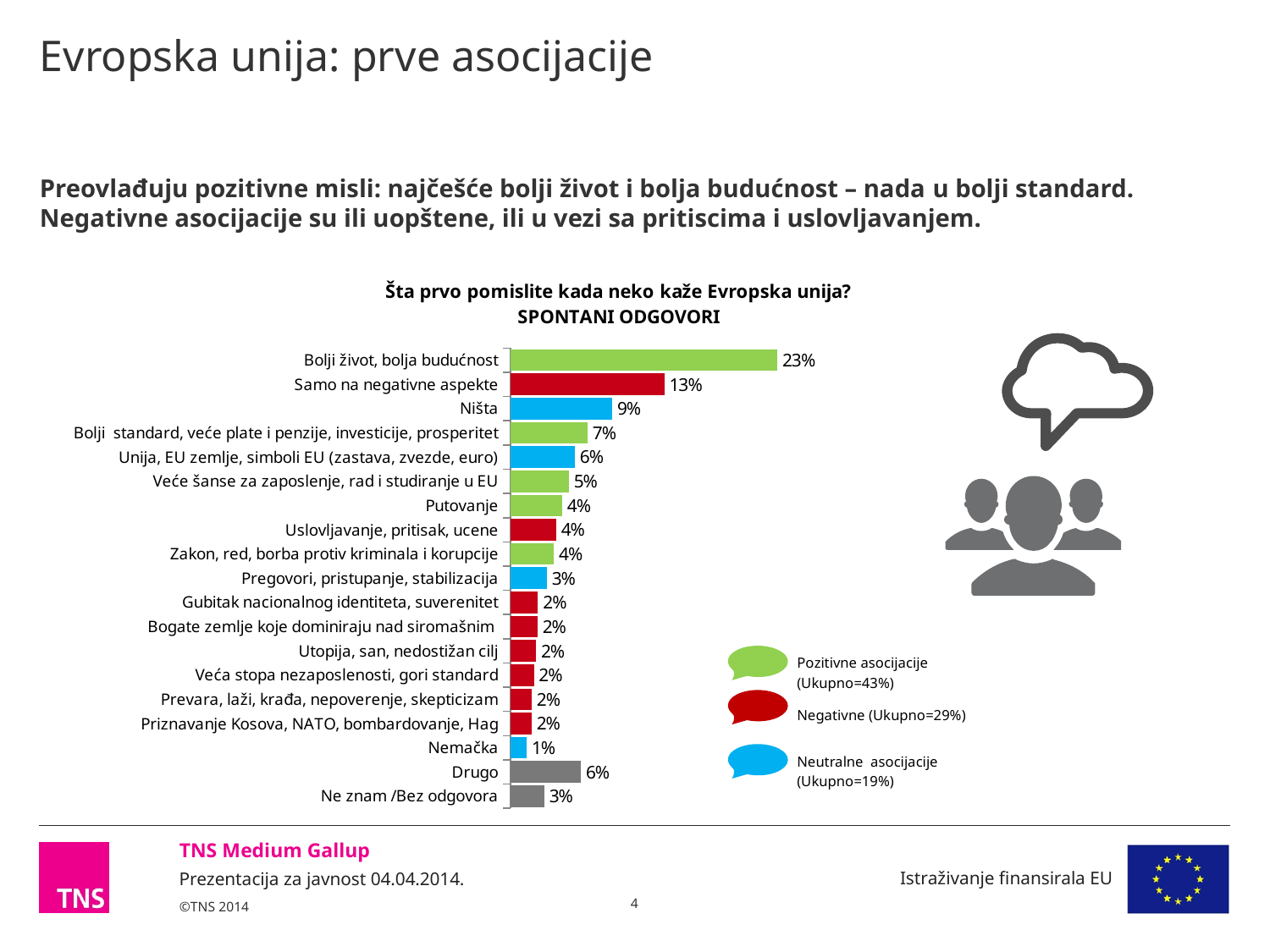
What type of chart is shown on the slide? Bar chart Which category has the highest value in the chart? Bolji život, bolja budućnost Which category has the lowest value in the chart? Nemačka Which is larger, the value for "Drugo" or the value for "Ne znam /Bez odgovora"? Drugo What percentage of respondents answered "Bolji život, bolja budućnost"? 23% According to the legend, what is the total for positive associations (Pozitivne asocijacije)? 43% How many categories are shown in the bar chart? 19 What is the value shown for "Ništa"? 9% What is the value shown for "Nemačka"? 1% What is the difference between the values for "Bolji život, bolja budućnost" and "Samo na negativne aspekte"? 10 percentage points What is the value shown for "Samo na negativne aspekte"? 13% What colour are the bars for negative associations (Negativne)? Red